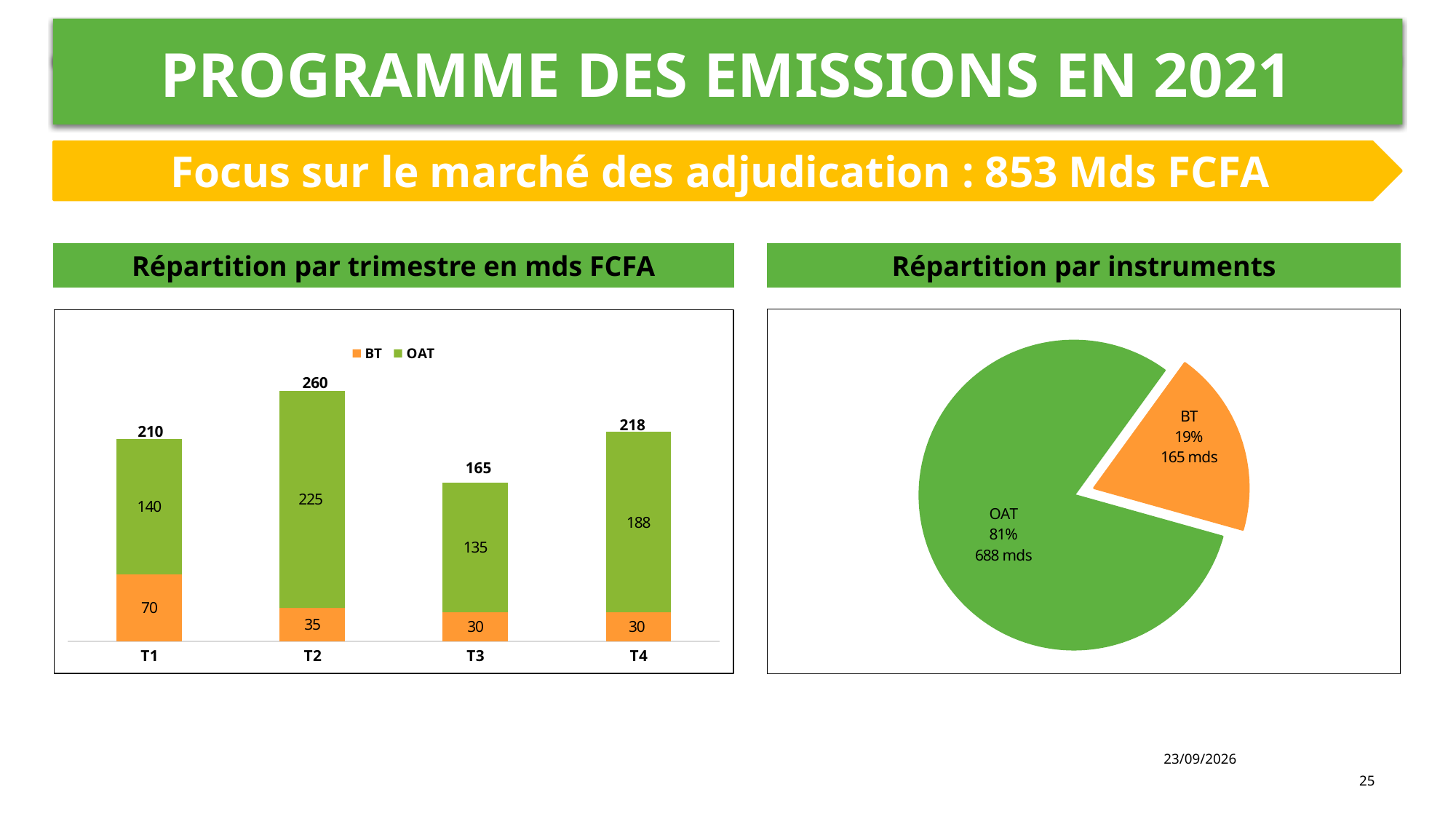
In the 'Répartition par trimestre en mds FCFA' chart, what is the OAT value for T2? 225 In the 'Répartition par trimestre en mds FCFA' chart, what is the BT value for T1? 70 In the 'Répartition par trimestre en mds FCFA' chart, which quarter has the lowest total? T3 In the 'Répartition par trimestre en mds FCFA' chart, is the BT value larger for T1 or for T2? T1 In the 'Répartition par trimestre en mds FCFA' chart, how many series does the legend list? 2 In the 'Répartition par trimestre en mds FCFA' chart, what is the total of the stacked bar for T4? 218 In the 'Répartition par trimestre en mds FCFA' chart, which quarter has the highest total? T2 What kind of chart is the 'Répartition par trimestre en mds FCFA' chart? Stacked bar chart In the 'Répartition par trimestre en mds FCFA' chart, how many quarters are shown on the x axis? 4 In the 'Répartition par instruments' pie chart, what is the value shown for BT? 165 mds In the 'Répartition par trimestre en mds FCFA' chart, what is the difference between the OAT values for T2 and T3? 90 In the 'Répartition par instruments' pie chart, what share does OAT represent? 81%